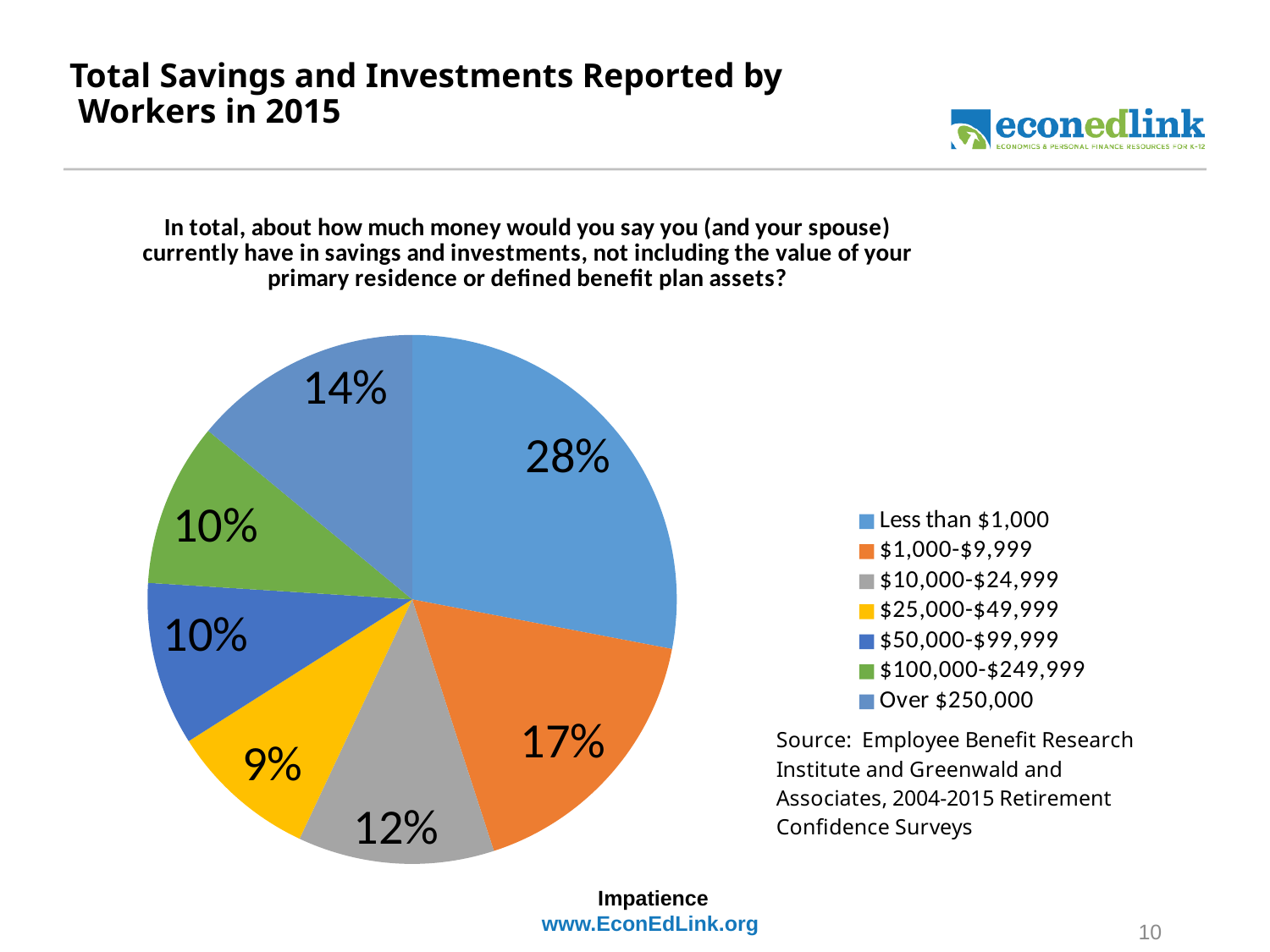
How many savings categories does the legend list? 7 What percentage of workers reported savings and investments of over $250,000? 14% What percentage of workers reported savings and investments of $25,000-$49,999? 9% What share of workers reported having less than $1,000 in savings and investments? 28% Which savings category has the smallest share of the pie? $25,000-$49,999 Which savings category has the largest share of the pie? Less than $1,000 Which is larger: the share for 'Over $250,000' or the share for '$10,000-$24,999'? Over $250,000 What kind of chart is shown on the slide? pie chart What percentage of workers reported savings and investments of $10,000-$24,999? 12% What percentage of workers reported savings and investments of $1,000-$9,999? 17% What colour is the slice for 'Less than $1,000'? light blue What is the difference in percentage points between the 'Less than $1,000' slice and the '$1,000-$9,999' slice? 11